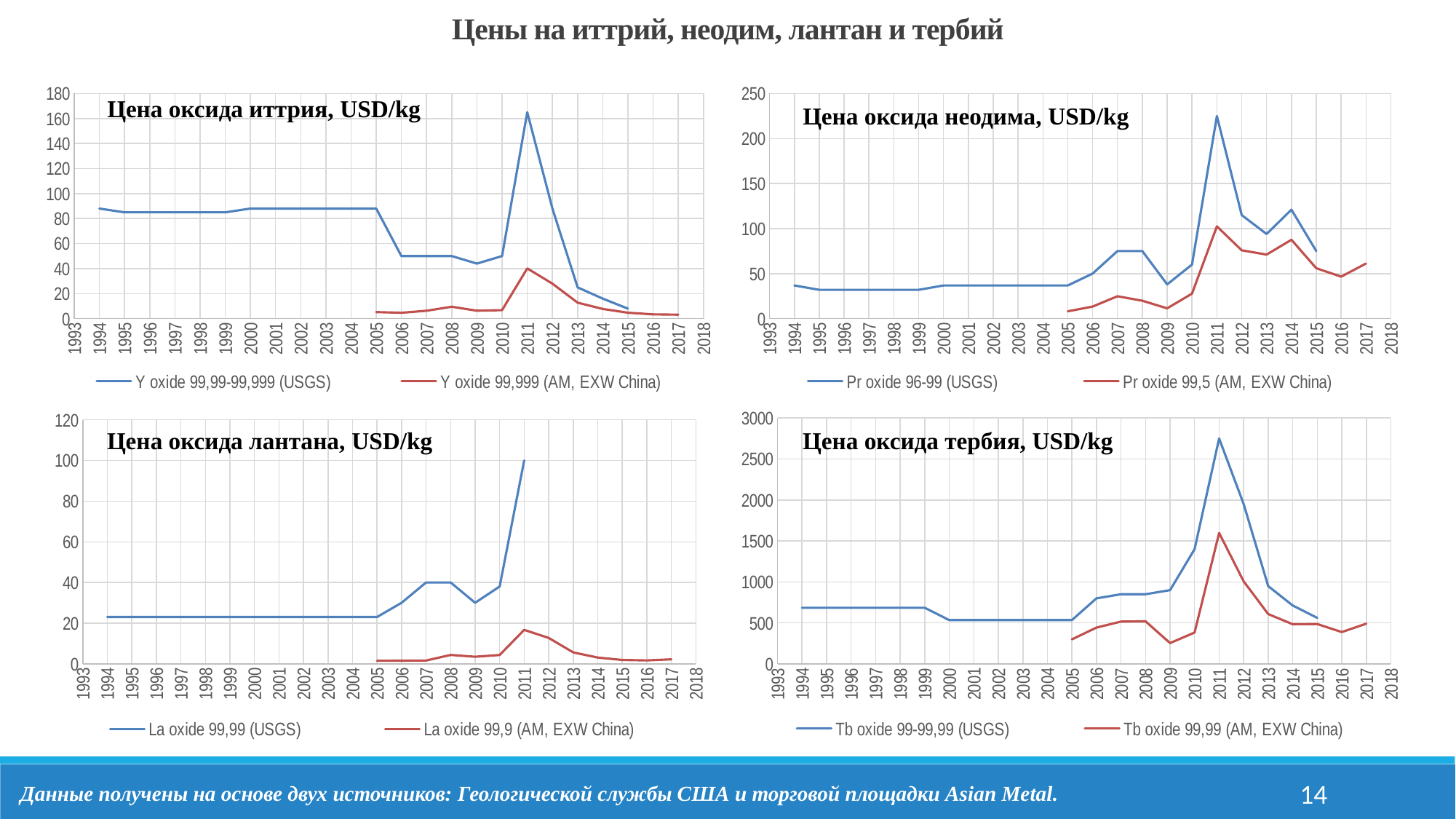
In the chart 'Цена оксида лантана, USD/kg', is the 2011 value for 'La oxide 99,99 (USGS)' greater or less than 80? greater In the chart 'Цена оксида иттрия, USD/kg', does the 'Y oxide 99,99-99,999 (USGS)' series rise or fall from 2011 to 2015? fall What are the two legend entries in the chart 'Цена оксида лантана, USD/kg'? La oxide 99,99 (USGS) and La oxide 99,9 (AM, EXW China) In the chart 'Цена оксида иттрия, USD/kg', is the 2011 value for 'Y oxide 99,99-99,999 (USGS)' greater or less than 140? greater In the chart 'Цена оксида тербия, USD/kg', is the 2011 value for 'Tb oxide 99-99,99 (USGS)' greater or less than 2500? greater In the chart 'Цена оксида иттрия, USD/kg', in which year does the 'Y oxide 99,99-99,999 (USGS)' series reach its highest value? 2011 In the chart 'Цена оксида тербия, USD/kg', which series has the higher value in 2011: 'Tb oxide 99-99,99 (USGS)' or 'Tb oxide 99,99 (AM, EXW China)'? Tb oxide 99-99,99 (USGS) In the chart 'Цена оксида иттрия, USD/kg', how many series does the legend list? 2 What kind of chart is 'Цена оксида иттрия, USD/kg'? line chart In the chart 'Цена оксида неодима, USD/kg', in which year does the 'Pr oxide 96-99 (USGS)' series peak? 2011 In the chart 'Цена оксида тербия, USD/kg', in which year does the 'Tb oxide 99-99,99 (USGS)' series reach its maximum? 2011